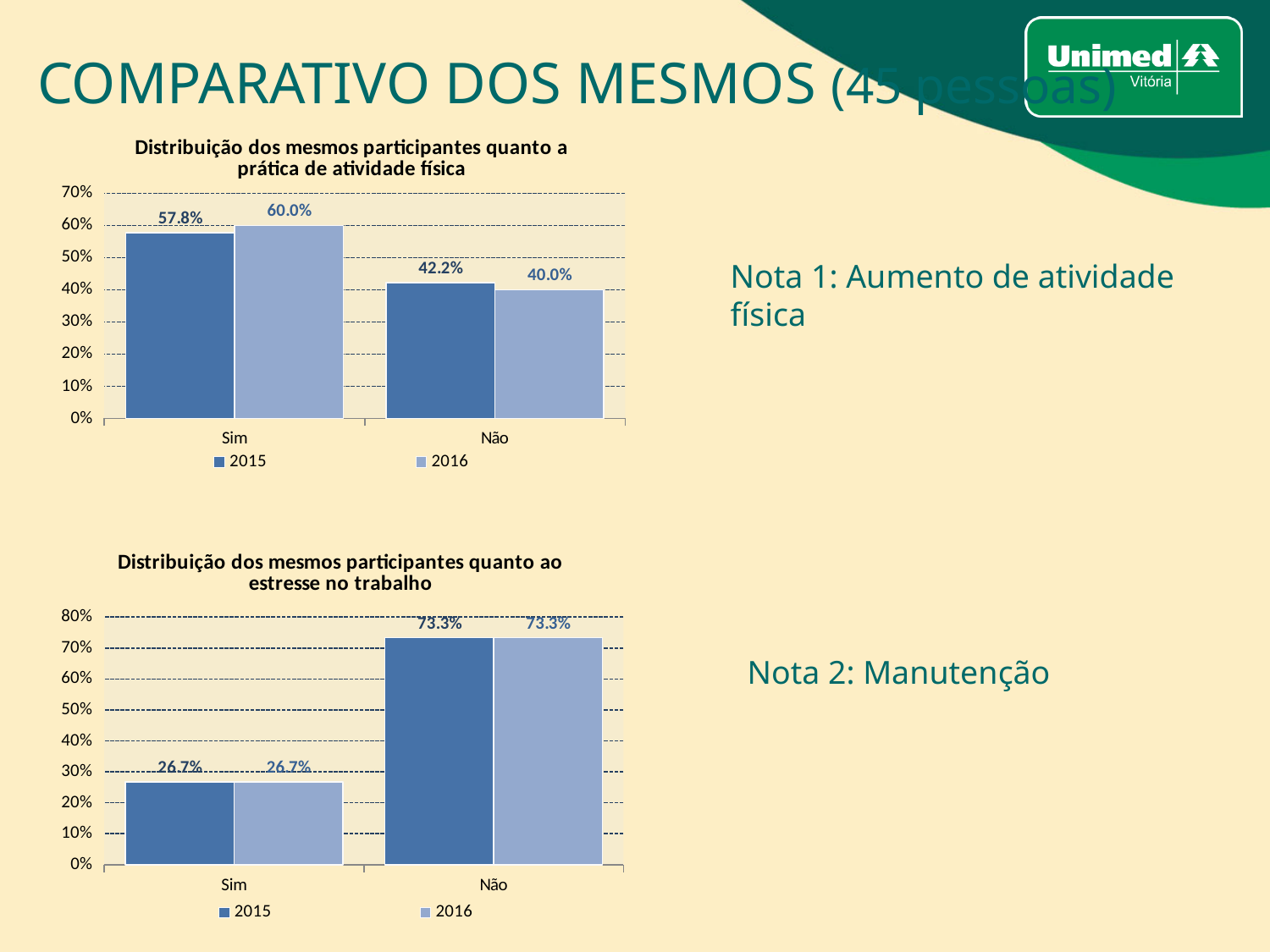
In the top chart (prática de atividade física), what is the value for 'Sim' in 2015? 57.8% In the bottom chart (estresse no trabalho), how many categories are shown on the x axis? 2 In the bottom chart (estresse no trabalho), what is the value for 'Não' in 2015? 73.3% In the top chart (prática de atividade física), which category has the highest 2016 value? Sim In the top chart (prática de atividade física), what is the difference between the 2016 and 2015 values for 'Sim'? 2.2% In the bottom chart (estresse no trabalho), what is the difference between the 'Não' and 'Sim' values for 2015? 46.6% In the top chart (prática de atividade física), how many series does the legend list? 2 In the bottom chart (estresse no trabalho), which category has the lowest 2015 value? Sim In the top chart (prática de atividade física), what is the value for 'Não' in 2016? 40.0% What type of chart is the bottom chart (estresse no trabalho)? Bar chart In the top chart (prática de atividade física), which is larger for 'Não': 2015 or 2016? 2015 In the bottom chart (estresse no trabalho), what is the value for 'Sim' in 2016? 26.7%